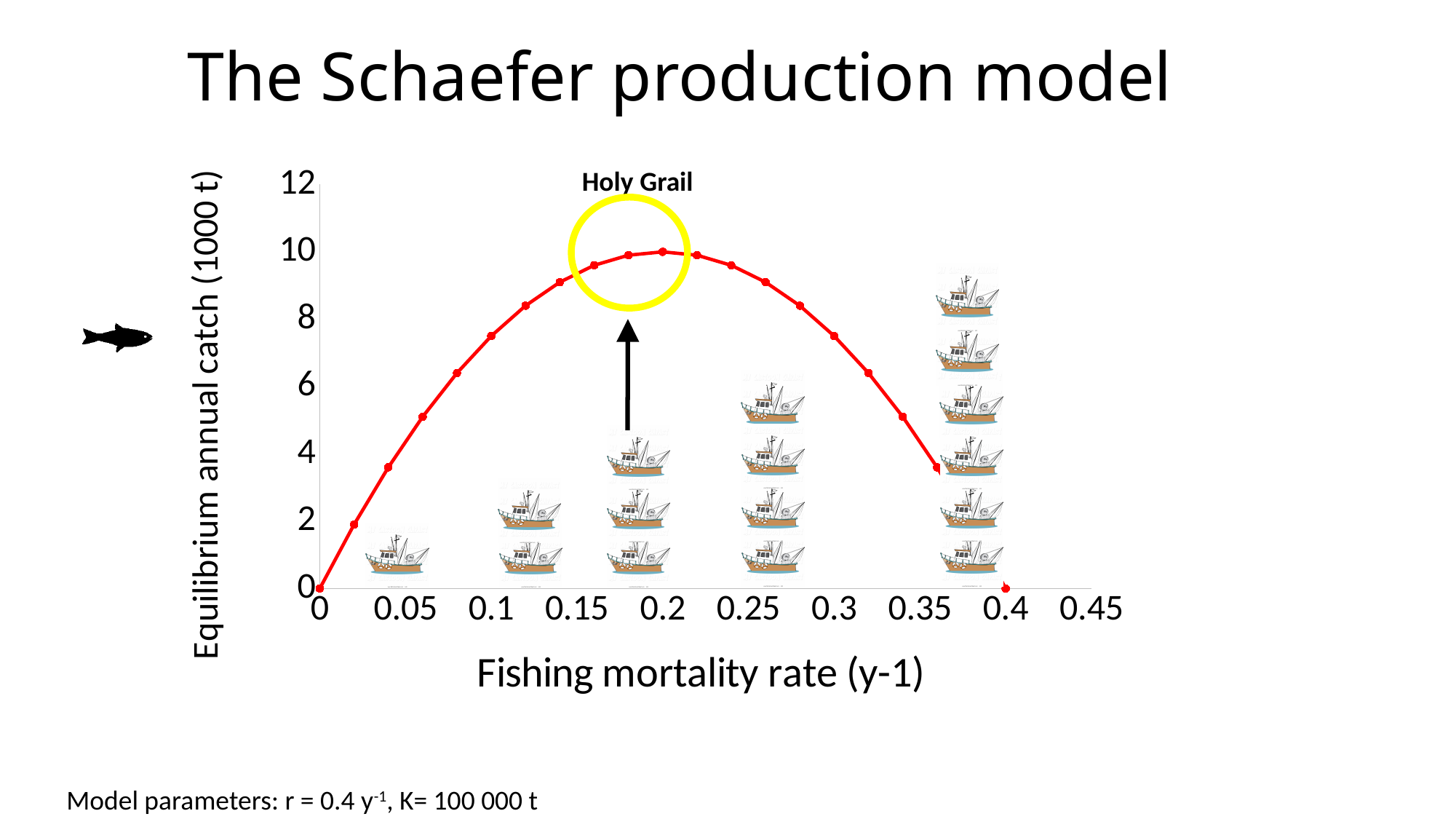
What kind of chart is shown on the slide? line chart What is the equilibrium annual catch at a fishing mortality rate of 0? 0 Does the equilibrium annual catch rise or fall as the fishing mortality rate increases from 0.2 to 0.4? fall Does the equilibrium annual catch rise or fall as the fishing mortality rate increases from 0 to 0.2? rise Is the equilibrium annual catch at a fishing mortality rate of 0.2 greater or less than 8? greater Is the equilibrium annual catch at a fishing mortality rate of 0.3 greater or less than 8? less Is the equilibrium annual catch at a fishing mortality rate of 0.1 greater or less than 6? greater What is the label of the x axis? Fishing mortality rate (y-1) Which has the larger equilibrium annual catch: a fishing mortality rate of 0.1 or 0.2? 0.2 What is the label of the y axis? Equilibrium annual catch (1000 t) What is the equilibrium annual catch at a fishing mortality rate of 0.4? 0 At which fishing mortality rate is the equilibrium annual catch highest? 0.2